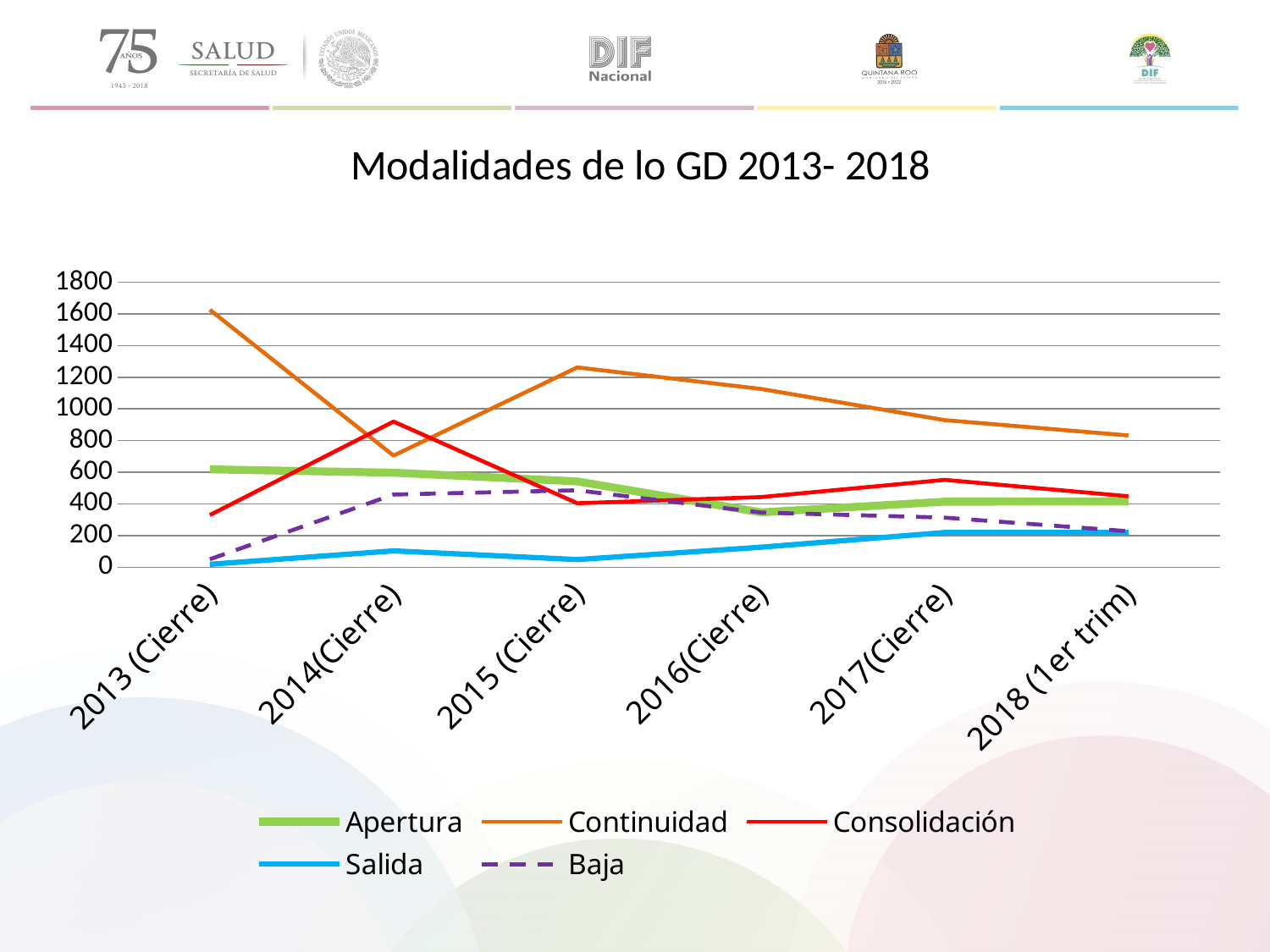
How many categories are shown along the x axis? 6 How many series does the legend list? 5 Is the value for Continuidad in 2013 (Cierre) greater or less than 1400? greater In 2014(Cierre), which is larger: Consolidación or Continuidad? Consolidación Is the value for Continuidad in 2018 (1er trim) greater or less than 1000? less Does the Continuidad line rise or fall from 2015 (Cierre) to 2018 (1er trim)? fall Which series has the lowest value in 2013 (Cierre)? Salida Is the value for Salida in 2013 (Cierre) greater or less than 200? less Which series is drawn with a dashed line? Baja What is the title of the chart? Modalidades de lo GD 2013- 2018 Which series has the highest value in 2013 (Cierre)? Continuidad What kind of chart is shown on the slide? line chart